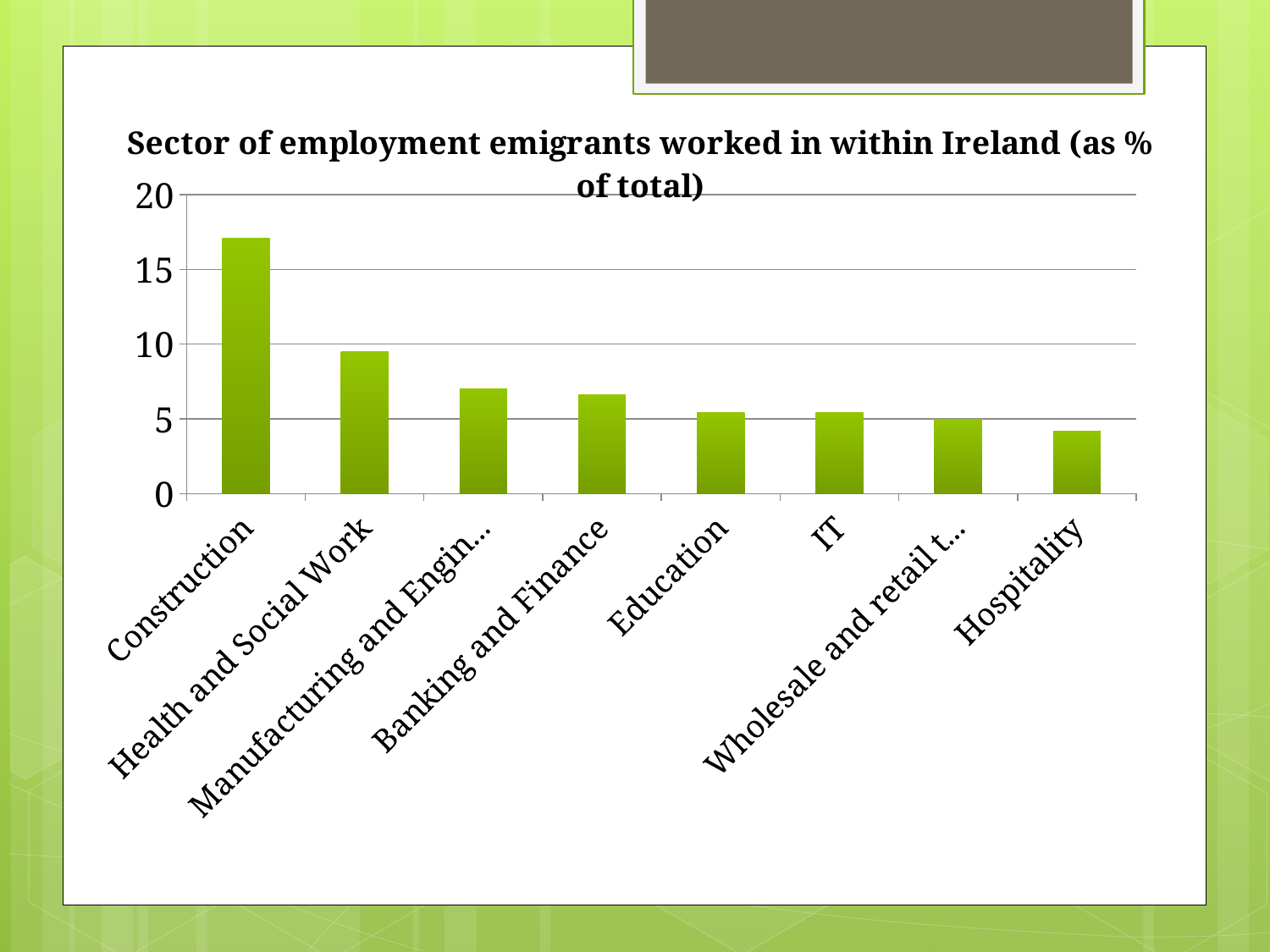
Is the value for Construction greater or less than 20? less How many sectors (categories) are plotted in the chart? 8 Is the value for Hospitality greater or less than 5? less Which sector has the highest value in the chart? Construction Do the bar values generally rise or fall moving from left to right across the chart? fall What kind of chart is shown on the slide? bar chart Which is larger, the value for Construction or the value for Health and Social Work? Construction Is the value for Banking and Finance greater or less than 5? greater Which sector has the lowest value in the chart? Hospitality What is the title of the chart? Sector of employment emigrants worked in within Ireland (as % of total)